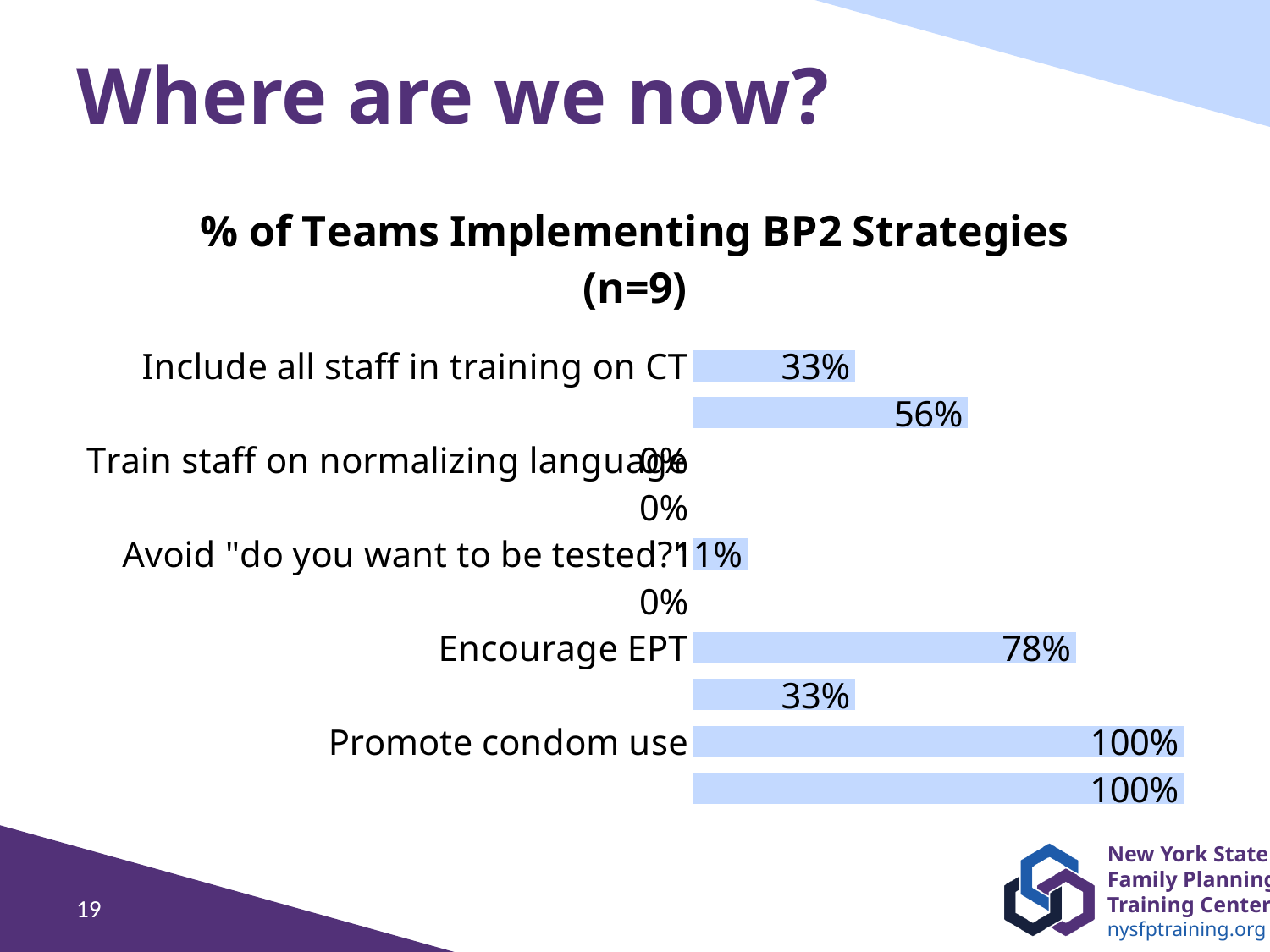
What is the value for "Include all staff in training on CT"? 33% How many bars are plotted in the chart? 10 What is the difference between the values for "Encourage EPT" and "Include all staff in training on CT"? 45 percentage points What is the value for "Avoid "do you want to be tested?""? 11% Among the labeled categories, which has the highest value? Promote condom use What is the value for "Encourage EPT"? 78% What kind of chart is shown on the slide? Bar chart Which is larger, the value for "Encourage EPT" or the value for "Include all staff in training on CT"? Encourage EPT What is the title of the chart? % of Teams Implementing BP2 Strategies (n=9) What is the value for "Train staff on normalizing language"? 0% What is the value for "Promote condom use"? 100% Among the labeled categories, which has the lowest value? Train staff on normalizing language